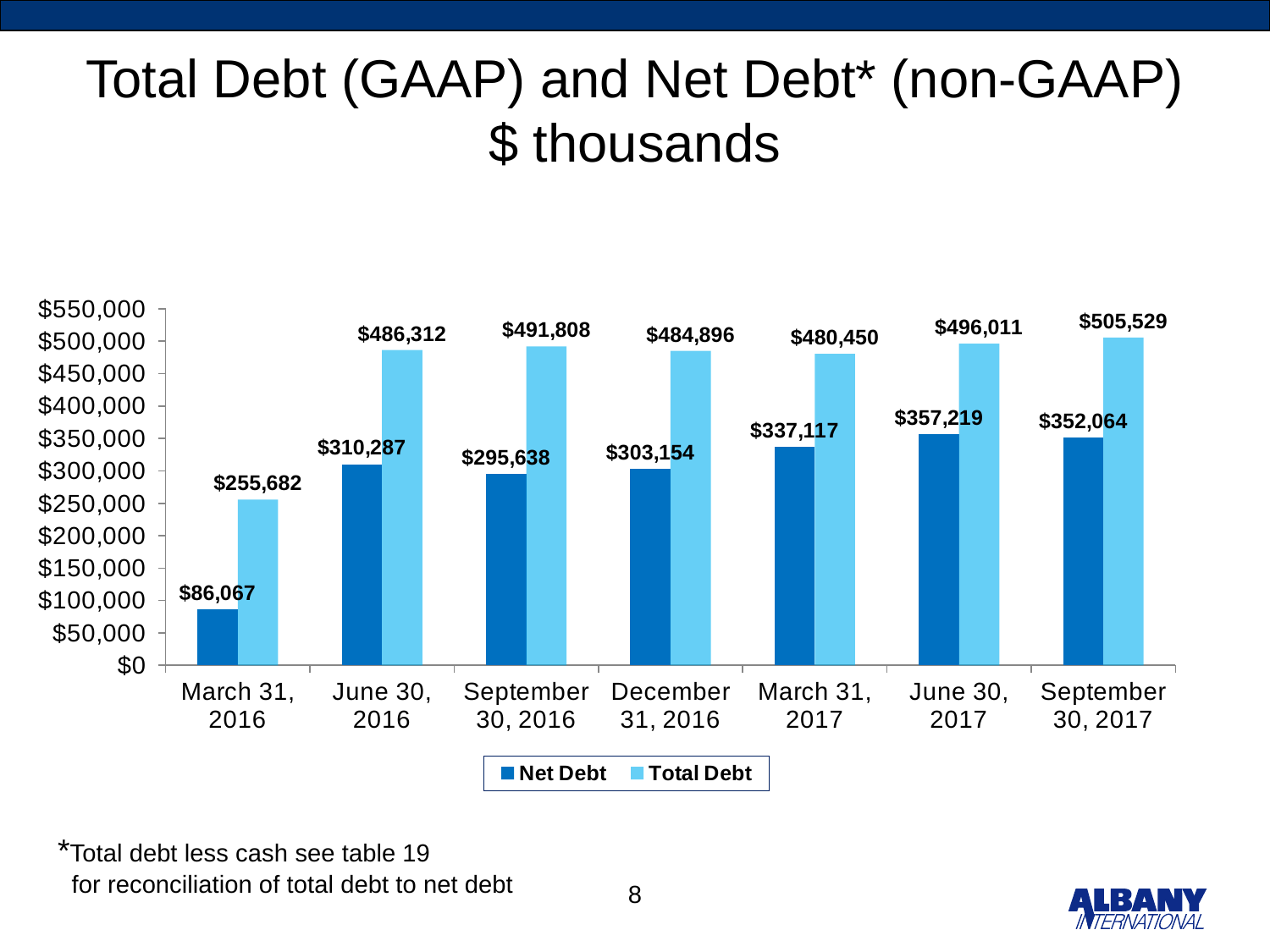
Which is larger, the Net Debt on June 30, 2017 or the Net Debt on September 30, 2017? June 30, 2017 What is the difference between Total Debt and Net Debt on September 30, 2017? $153,465 What is the Net Debt value for March 31, 2016? $86,067 How many periods are shown on the x axis? 7 What is the Net Debt value for December 31, 2016? $303,154 What are the two series named in the legend? Net Debt and Total Debt What kind of chart is shown on the slide? Bar chart How many series does the legend list? 2 What is the Total Debt value for September 30, 2017? $505,529 Which period has the lowest Net Debt? March 31, 2016 What is the Total Debt value for March 31, 2017? $480,450 Which period has the highest Total Debt? September 30, 2017